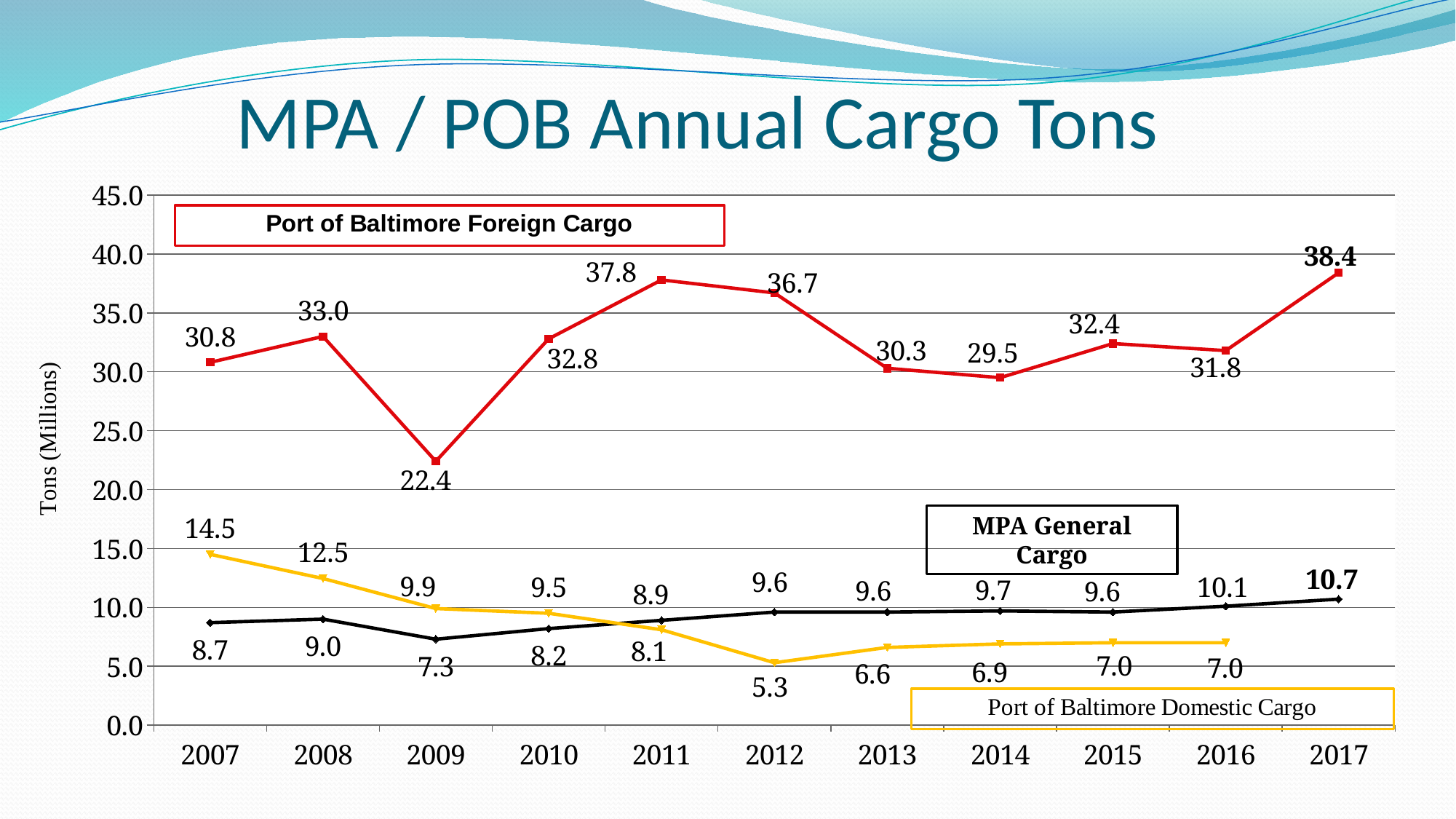
Did Port of Baltimore Domestic Cargo rise or fall from 2007 to 2012? Fall In which year was Port of Baltimore Foreign Cargo highest? 2017 In which year was Port of Baltimore Domestic Cargo highest? 2007 What was the MPA General Cargo value in 2017? 10.7 Which was larger in 2011: MPA General Cargo or Port of Baltimore Domestic Cargo? MPA General Cargo How many data series are plotted on the chart? 3 What was the Port of Baltimore Foreign Cargo value in 2009? 22.4 What is the difference between Port of Baltimore Foreign Cargo in 2017 and in 2016? 6.6 What was the Port of Baltimore Domestic Cargo value in 2012? 5.3 In which year was Port of Baltimore Foreign Cargo lowest? 2009 How many years are shown on the x axis? 11 What type of chart is shown on the slide? Line chart